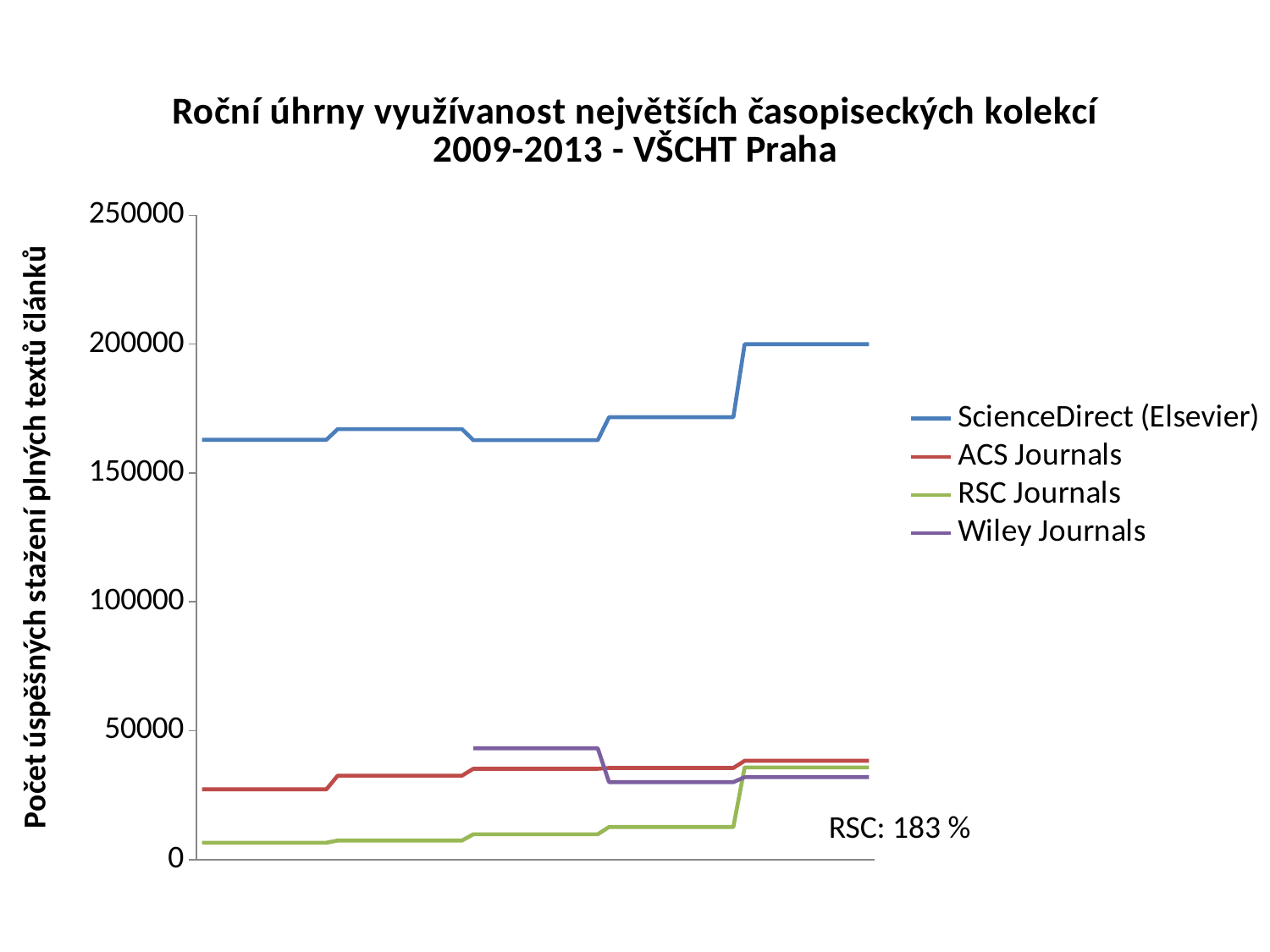
Which series has the highest values throughout the chart? ScienceDirect (Elsevier) Does the RSC Journals line rise or fall overall from left to right? rise Is the value for RSC Journals at the left end of the chart greater or less than 50000? less What percentage is shown in the annotation for RSC on the chart? 183 % Which series is larger at the right end of the chart, ScienceDirect (Elsevier) or ACS Journals? ScienceDirect (Elsevier) Which series has the lowest values at the left end of the chart? RSC Journals What kind of chart is shown on the slide? line chart Is the value for ACS Journals at the right end of the chart greater or less than 50000? less Is the value for ScienceDirect (Elsevier) at the right end of the chart greater or less than 150000? greater How many series does the legend list? 4 What is the title of the chart? Roční úhrny využívanost největších časopiseckých kolekcí 2009-2013 - VŠCHT Praha Does the ScienceDirect (Elsevier) line rise or fall overall from left to right? rise